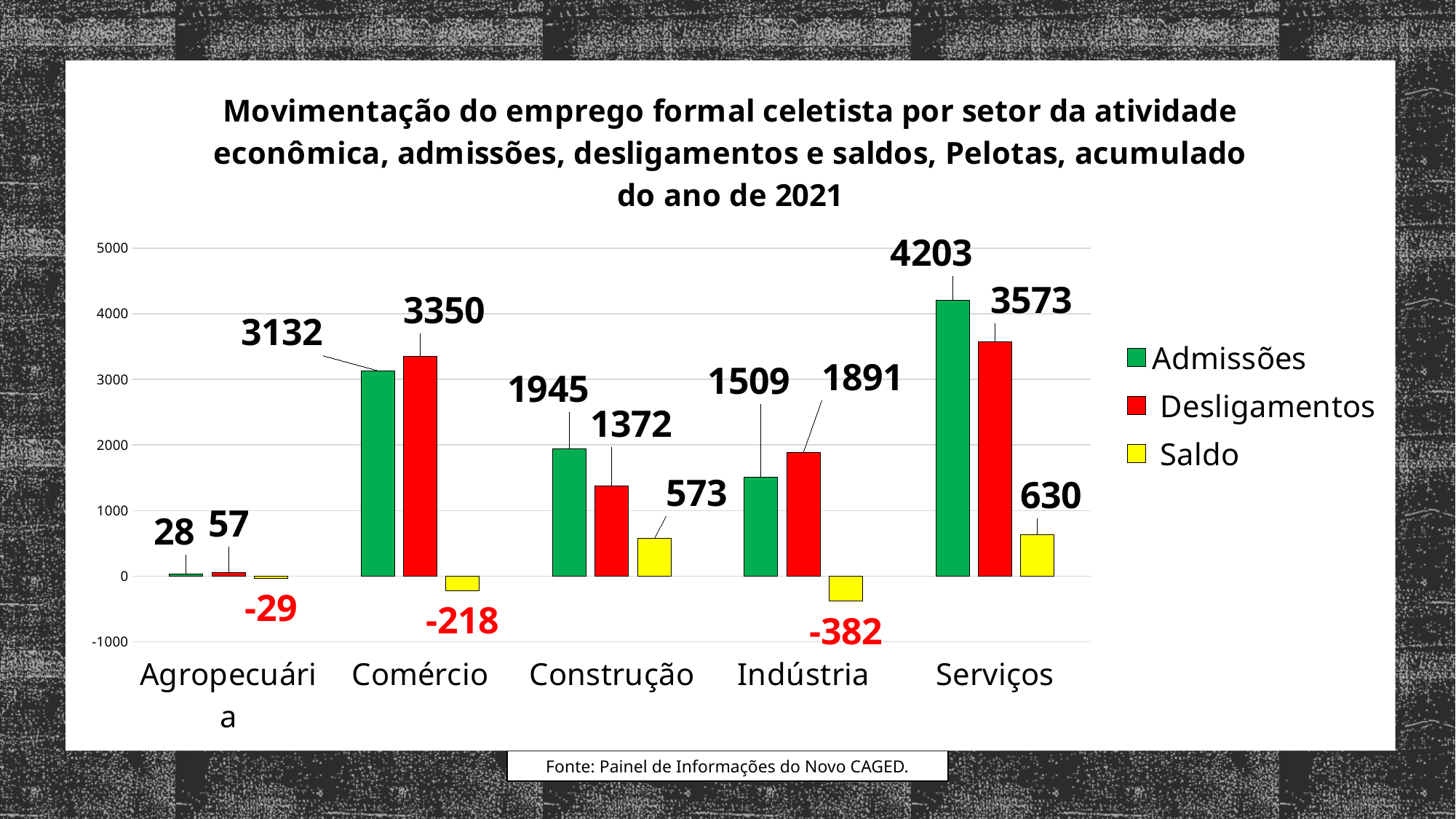
How many series does the legend list? 3 What is the Desligamentos value for Comércio? 3350 What kind of chart is shown on the slide? Bar chart What is the Saldo value for Indústria? -382 What is the Admissões value for Serviços? 4203 Which sector has the highest Admissões value? Serviços Which colour represents the Saldo series in the legend? Yellow Which sector has the lowest Saldo value? Indústria Which is larger for Indústria, Admissões or Desligamentos? Desligamentos What is the difference between Admissões and Desligamentos for Construção? 573 What is the Admissões value for Agropecuária? 28 How many sectors are shown on the x axis? 5